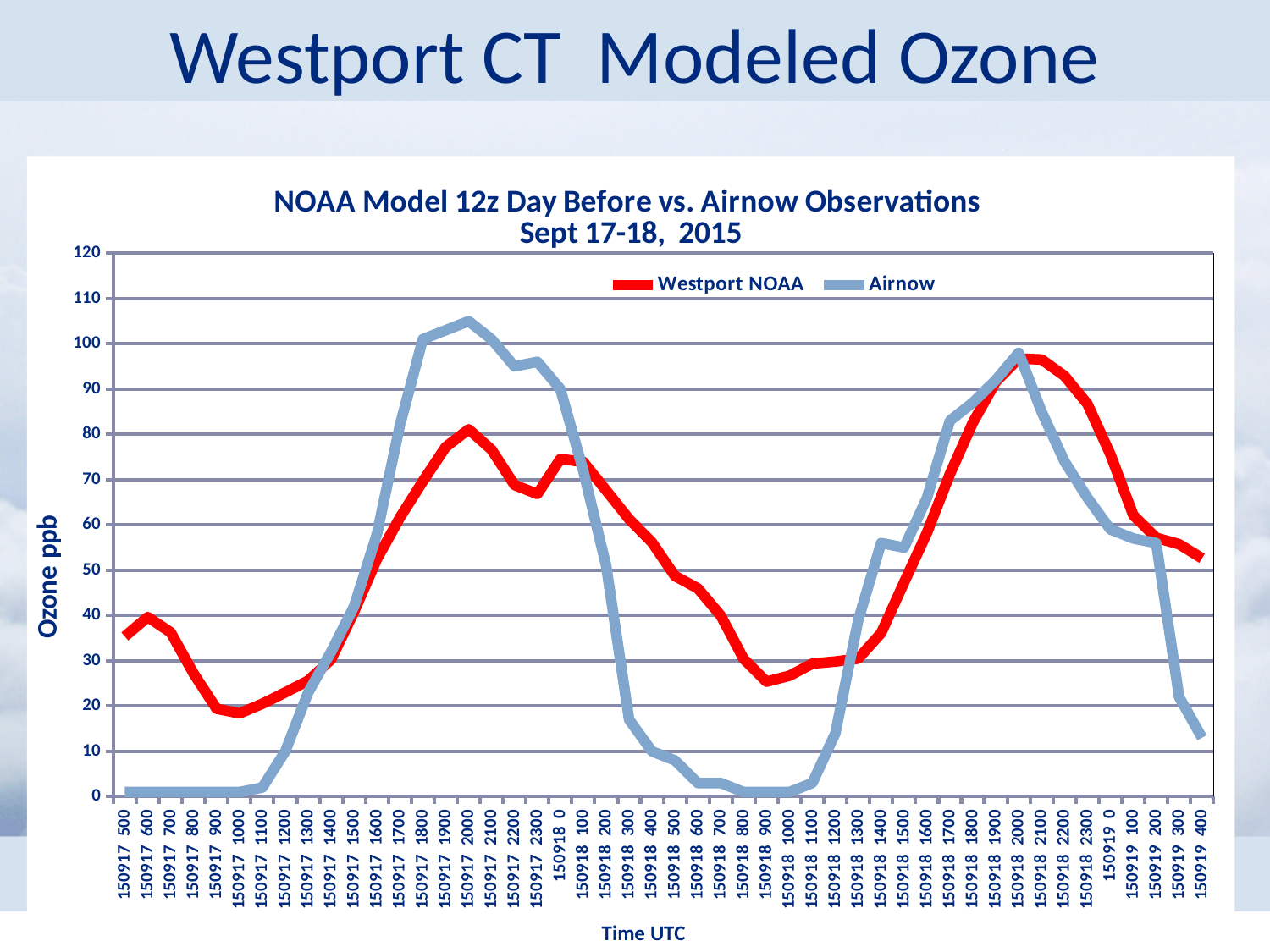
Which series reaches the highest peak value on the chart? Airnow At 150917 2000, which series has the higher value, Westport NOAA or Airnow? Airnow At 150918 300, which series has the higher value, Westport NOAA or Airnow? Westport NOAA Is the Airnow value at 150918 800 greater or less than 10? less How many time points are plotted along the x axis? 48 Is the Airnow value at 150917 2000 greater or less than 100? greater Which series is drawn in red? Westport NOAA Is the Westport NOAA value at 150918 900 greater or less than 30? less What is the label on the y axis? Ozone ppb What kind of chart is shown on the slide? line chart How many series does the legend list? 2